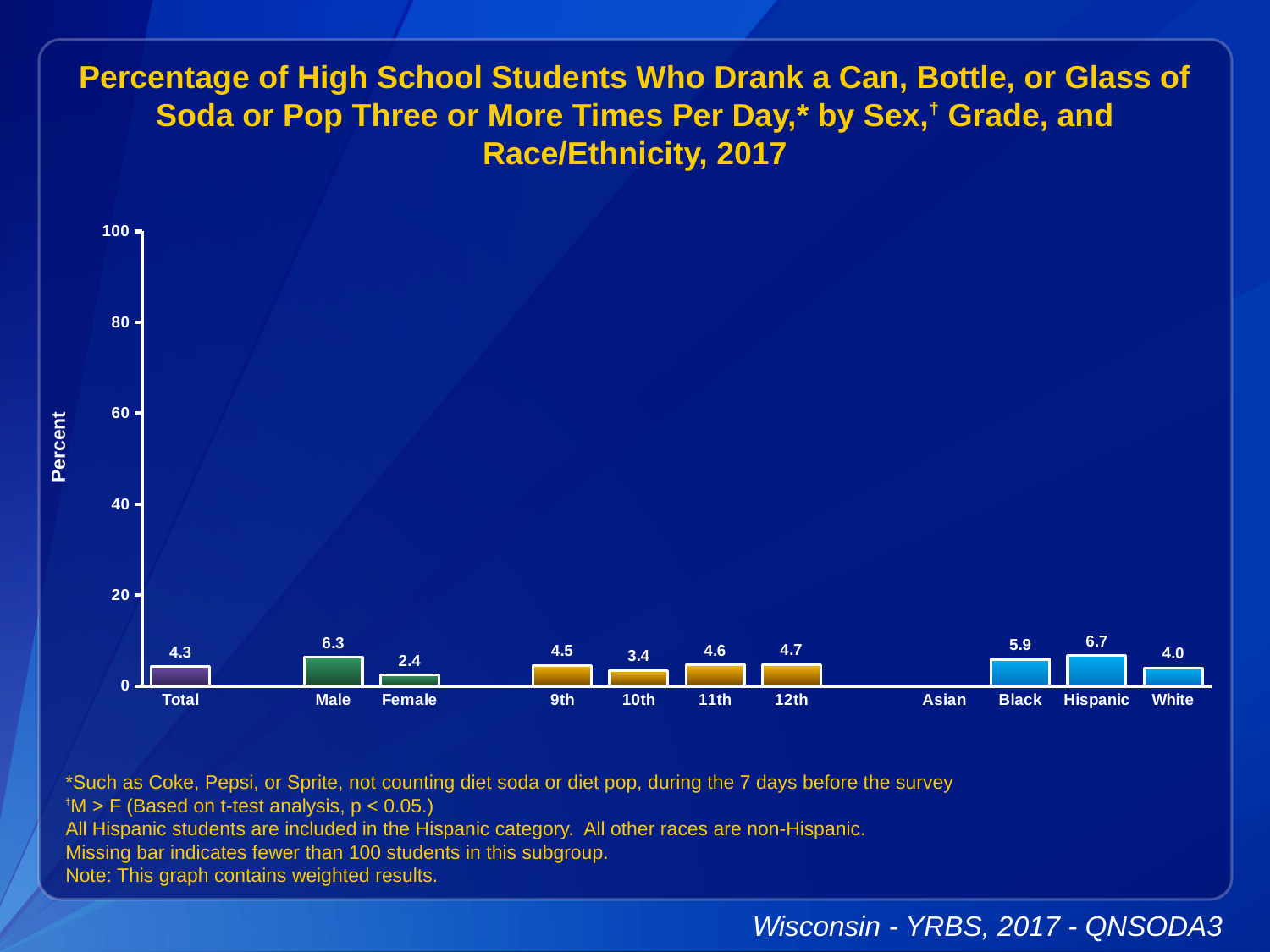
Which category has the highest value? Hispanic Is the value for 12th grade greater or less than 20? less What is the value for Total? 4.3 What is the difference between the Male and Female values? 3.9 Which category has the lowest value among the bars shown? Female What is the value for Female? 2.4 What is the value for Male? 6.3 What is the value for 10th grade? 3.4 What kind of chart is shown on the slide? bar chart Which category on the x axis has no bar shown? Asian What is the value for Hispanic? 6.7 Which is larger, the value for Black or the value for White? Black